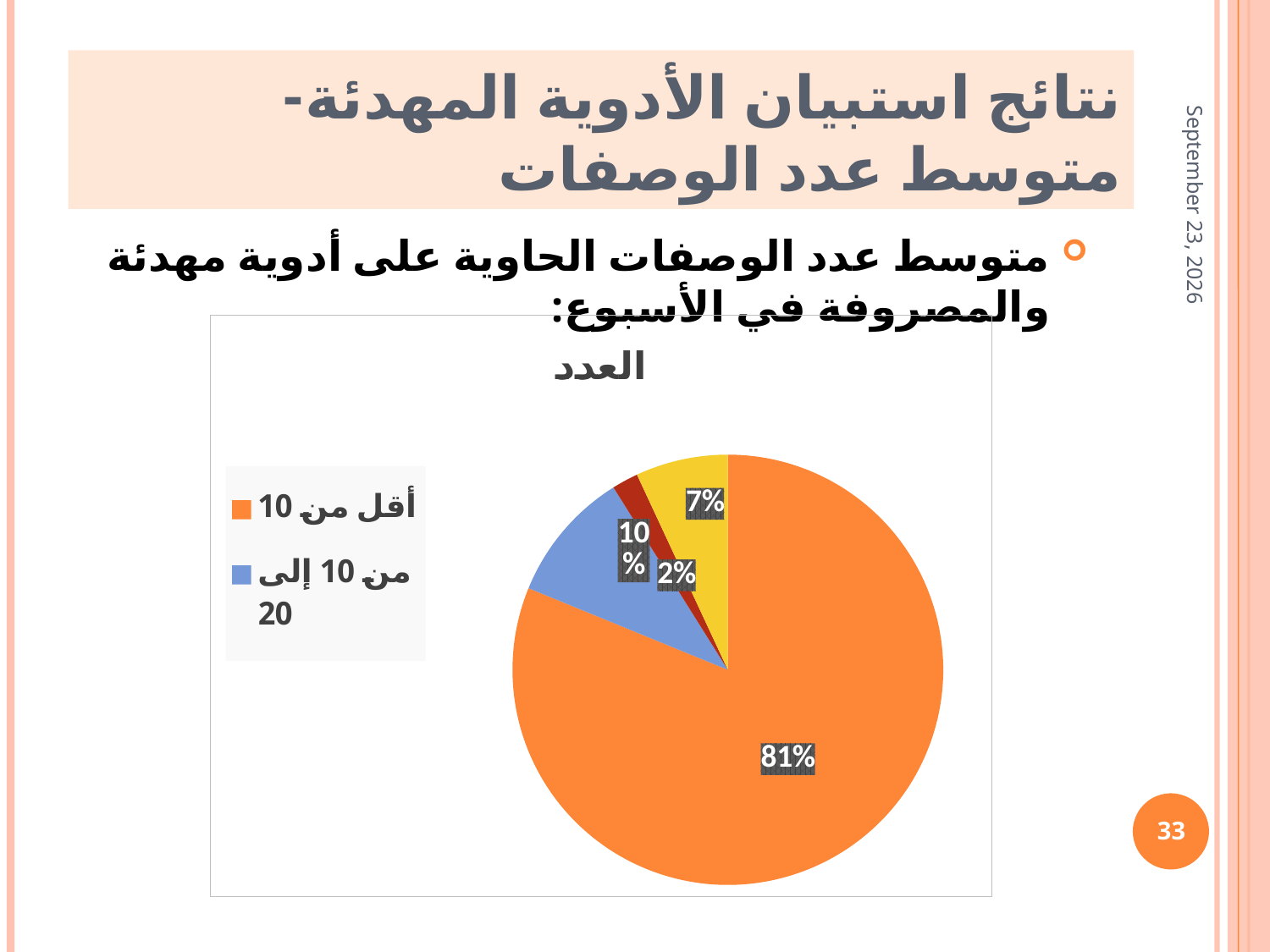
What is the difference in percentage points between the "أقل من 10" slice and the "من 10 إلى 20" slice? 71 What percentage is shown for the "من 10 إلى 20" slice? 10% What colour is the largest slice of the pie chart? orange What kind of chart is shown on the slide? pie chart Which is larger, the "أقل من 10" slice or the "من 10 إلى 20" slice? أقل من 10 Which category has the largest slice of the pie? أقل من 10 What percentage is shown on the yellow slice of the pie chart? 7% What percentage of the pie does the slice for "أقل من 10" represent? 81% What is the smallest percentage labelled on the pie chart? 2% How many entries are listed in the chart's legend? 2 How many slices does the pie chart have? 4 What is the title of the pie chart? العدد